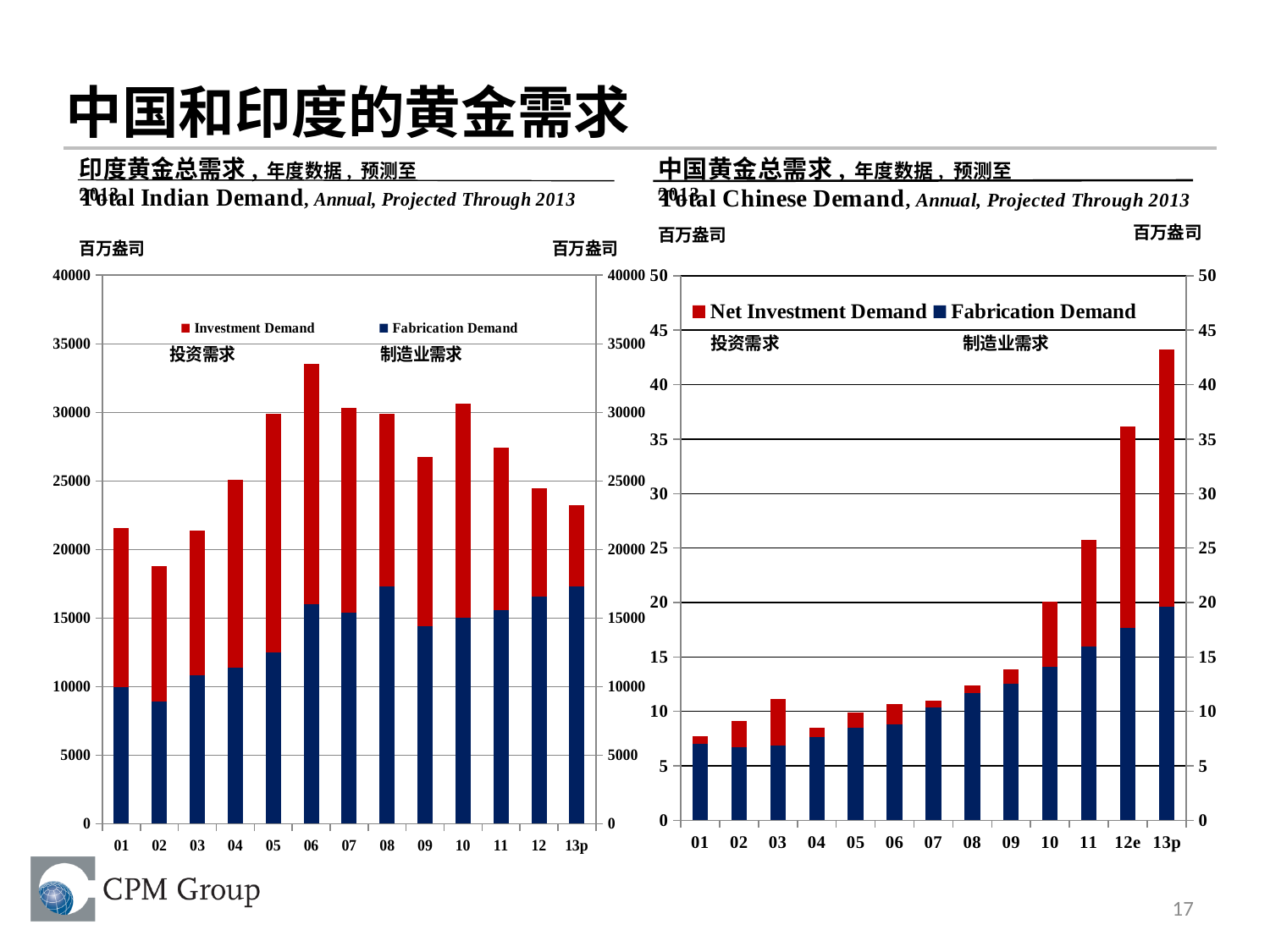
In the Total Chinese Demand chart, which year has the lowest total demand? 01 What are the two series shown in the Total Indian Demand chart's legend? Investment Demand and Fabrication Demand How many series does the legend of the Total Chinese Demand chart list? 2 In the Total Indian Demand chart, is the total demand for 06 greater or less than 30000? greater What kind of chart is the Total Indian Demand chart? stacked bar chart In the Total Chinese Demand chart, is the total demand for 01 greater or less than 10? less In the Total Chinese Demand chart, do total demand values generally rise or fall from 01 to 13p? rise In the Total Indian Demand chart, which year has the lowest total demand? 02 In the Total Chinese Demand chart, is the total demand for 13p greater or less than 40? greater In the Total Chinese Demand chart, which year has the highest total demand? 13p How many years (bars) are plotted in the Total Chinese Demand chart? 13 In the Total Indian Demand chart, which year has the highest total demand? 06